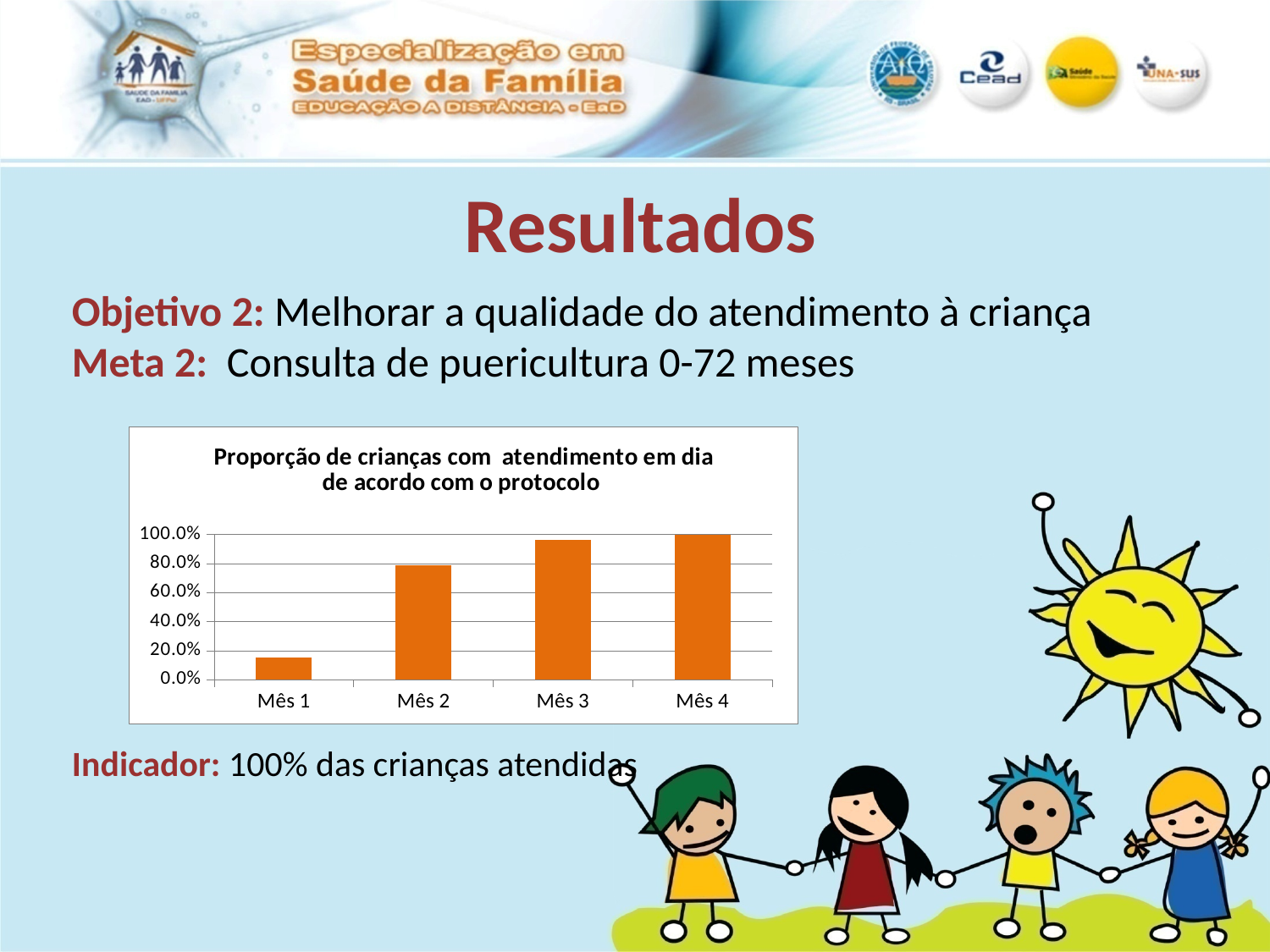
Which is larger, the value for Mês 3 or the value for Mês 2? Mês 3 Which month has the lowest proportion in the chart? Mês 1 What kind of chart is shown on the slide? bar chart Is the value for Mês 3 greater or less than 80.0%? greater Do the values rise or fall from Mês 1 to Mês 4? rise Is the value for Mês 2 greater or less than 60.0%? greater What is the value for Mês 4 in the chart? 100.0% Which is larger, the value for Mês 2 or the value for Mês 1? Mês 2 Is the value for Mês 1 greater or less than 20.0%? less What is the title of the chart? Proporção de crianças com atendimento em dia de acordo com o protocolo Which month has the highest proportion in the chart? Mês 4 How many months (categories) are shown on the x axis of the chart? 4